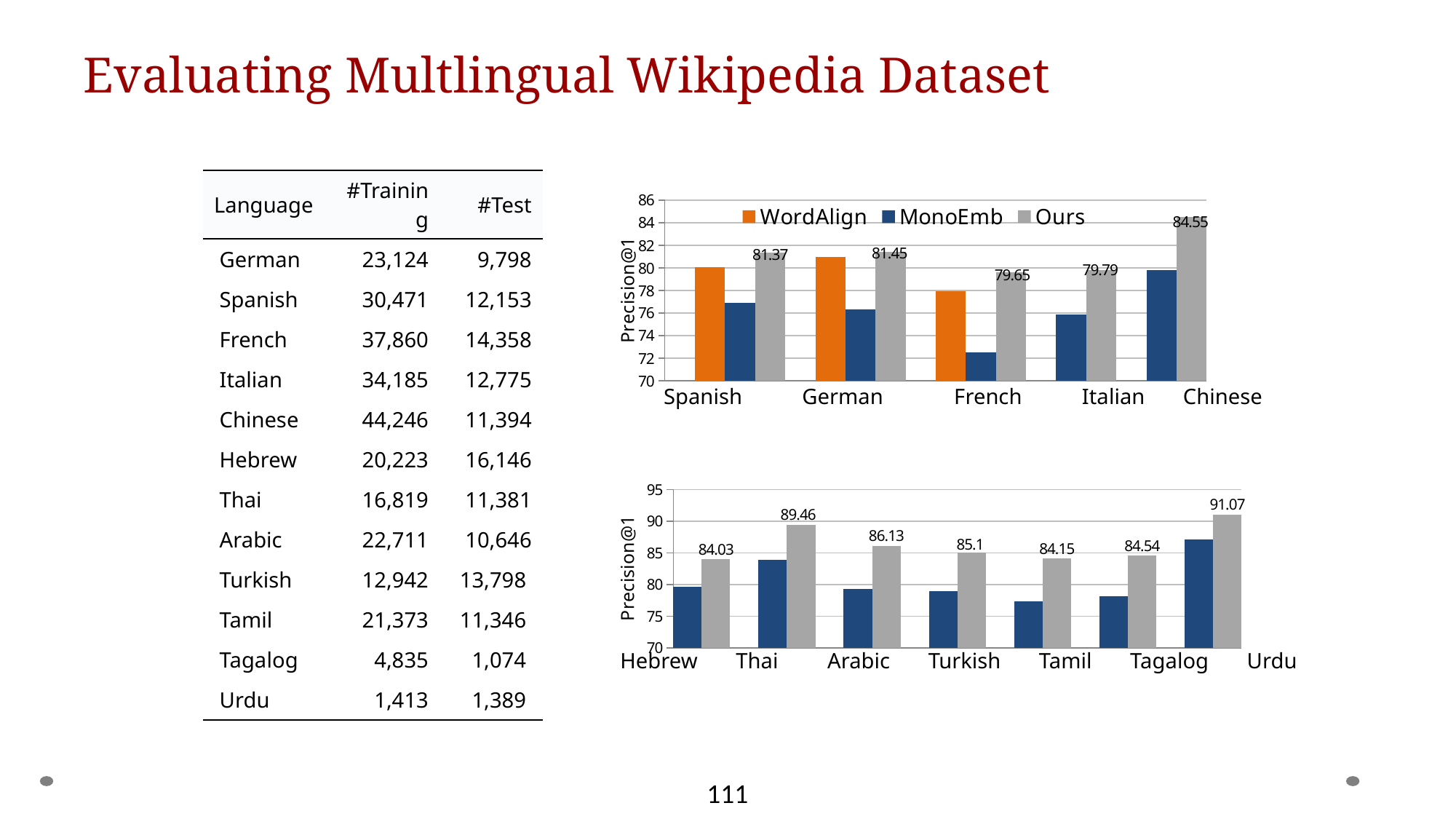
In the top chart, what is the difference between the Ours values for Chinese and Spanish? 3.18 In the bottom chart, what is the value printed above the grey bar for Urdu? 91.07 How many series does the legend of the top chart list? 3 In the top chart, is the WordAlign value for French greater or less than 80? less In the bottom chart, what is the difference between the labelled values for Urdu and Thai? 1.61 In the top chart, what is the Precision@1 value of Ours for Chinese? 84.55 In the bottom chart, is the dark blue bar for Tamil greater or less than 80? less How many languages are shown on the x axis of the top chart? 5 In the bottom chart, which language has the lowest labelled grey bar value? Hebrew What kind of chart is the bottom chart? bar chart In the top chart, which is larger: the Ours value for German or for Spanish? German In the top chart, which language has the highest value for Ours? Chinese